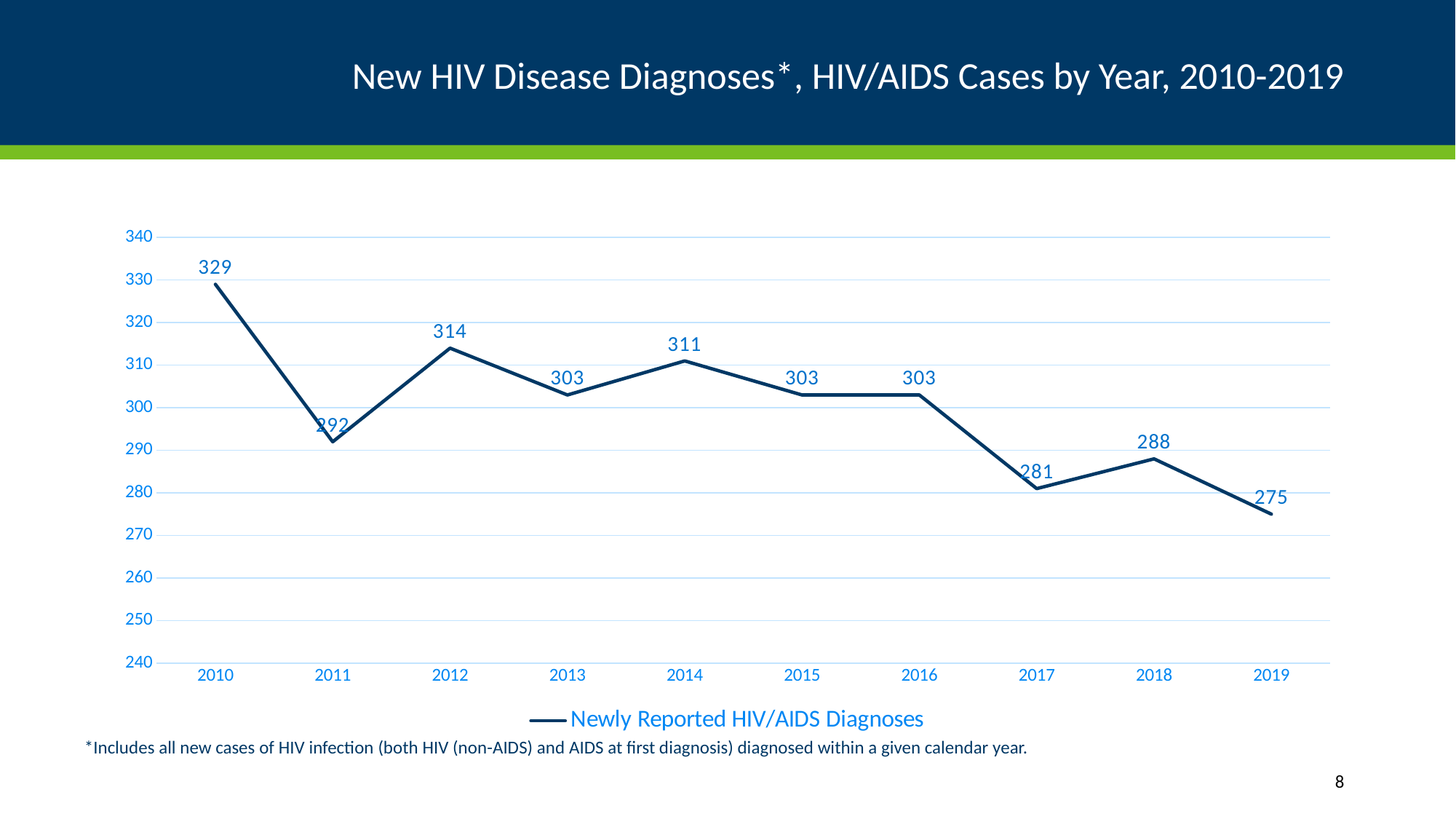
What was the number of newly reported HIV/AIDS diagnoses in 2019? 275 How many years are plotted on the chart? 10 Which year had more diagnoses, 2017 or 2018? 2018 What is the difference between the values for 2010 and 2019? 54 What is the difference between the values for 2012 and 2011? 22 What was the number of newly reported HIV/AIDS diagnoses in 2010? 329 Which year had the highest number of newly reported HIV/AIDS diagnoses? 2010 What kind of chart is shown on the slide? line chart Is the value for 2011 greater or less than 300? less What is the overall trend in newly reported HIV/AIDS diagnoses from 2010 to 2019? falling What value is shown for 2014? 311 Which year had the lowest number of newly reported HIV/AIDS diagnoses? 2019